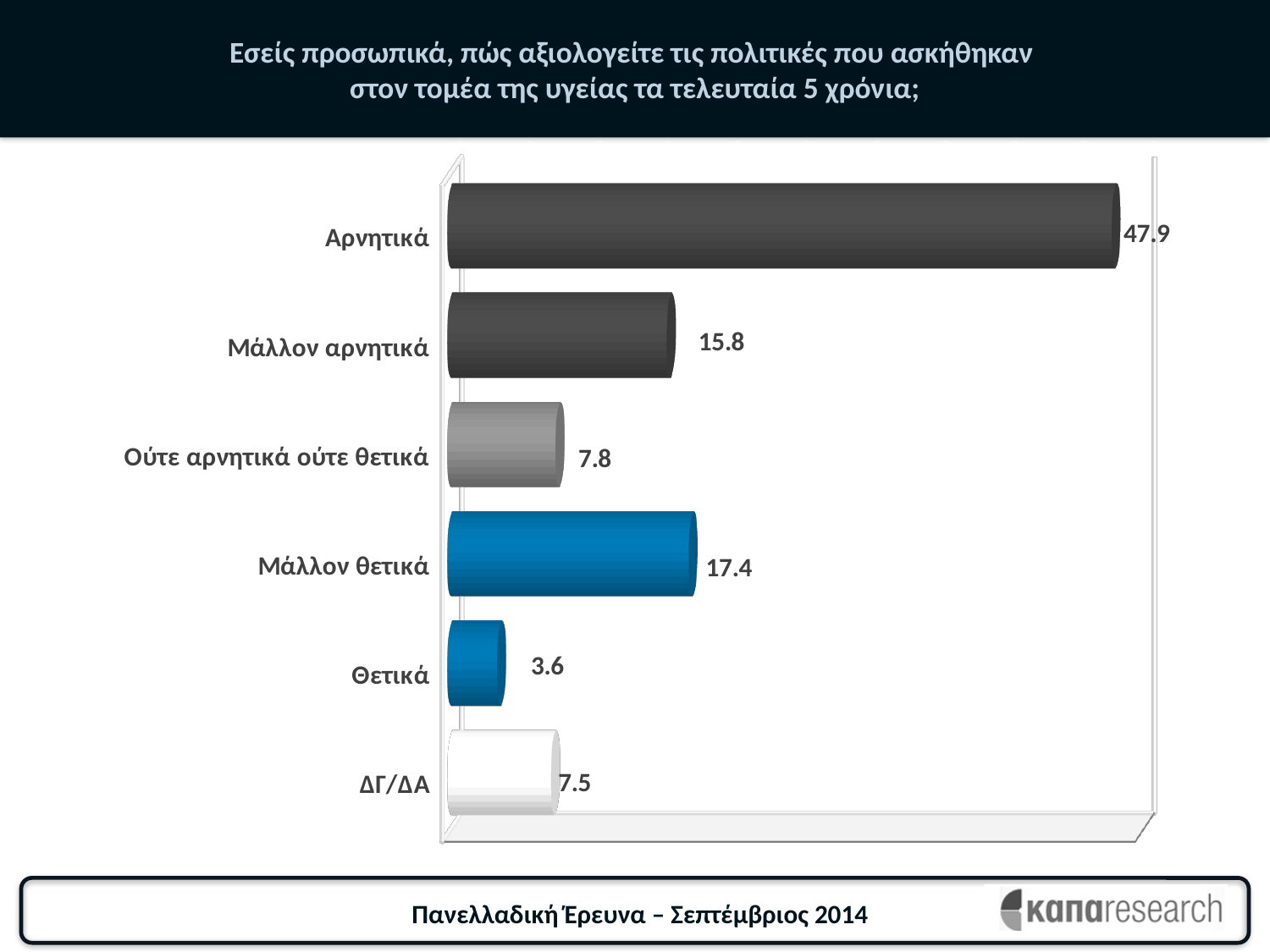
Which is larger, the value for Μάλλον θετικά or the value for Μάλλον αρνητικά? Μάλλον θετικά What is the total of the values for Μάλλον θετικά and Θετικά? 21.0 What is the value for Μάλλον θετικά? 17.4 Which category has the lowest value? Θετικά What is the value for Αρνητικά? 47.9 What colour are the bars for Μάλλον θετικά and Θετικά? Blue Which category has the highest value? Αρνητικά How many categories are shown in the chart? 6 What kind of chart is shown on the slide? Bar chart What is the difference between the values for Αρνητικά and Μάλλον αρνητικά? 32.1 What is the value for ΔΓ/ΔΑ? 7.5 What is the value for Θετικά? 3.6